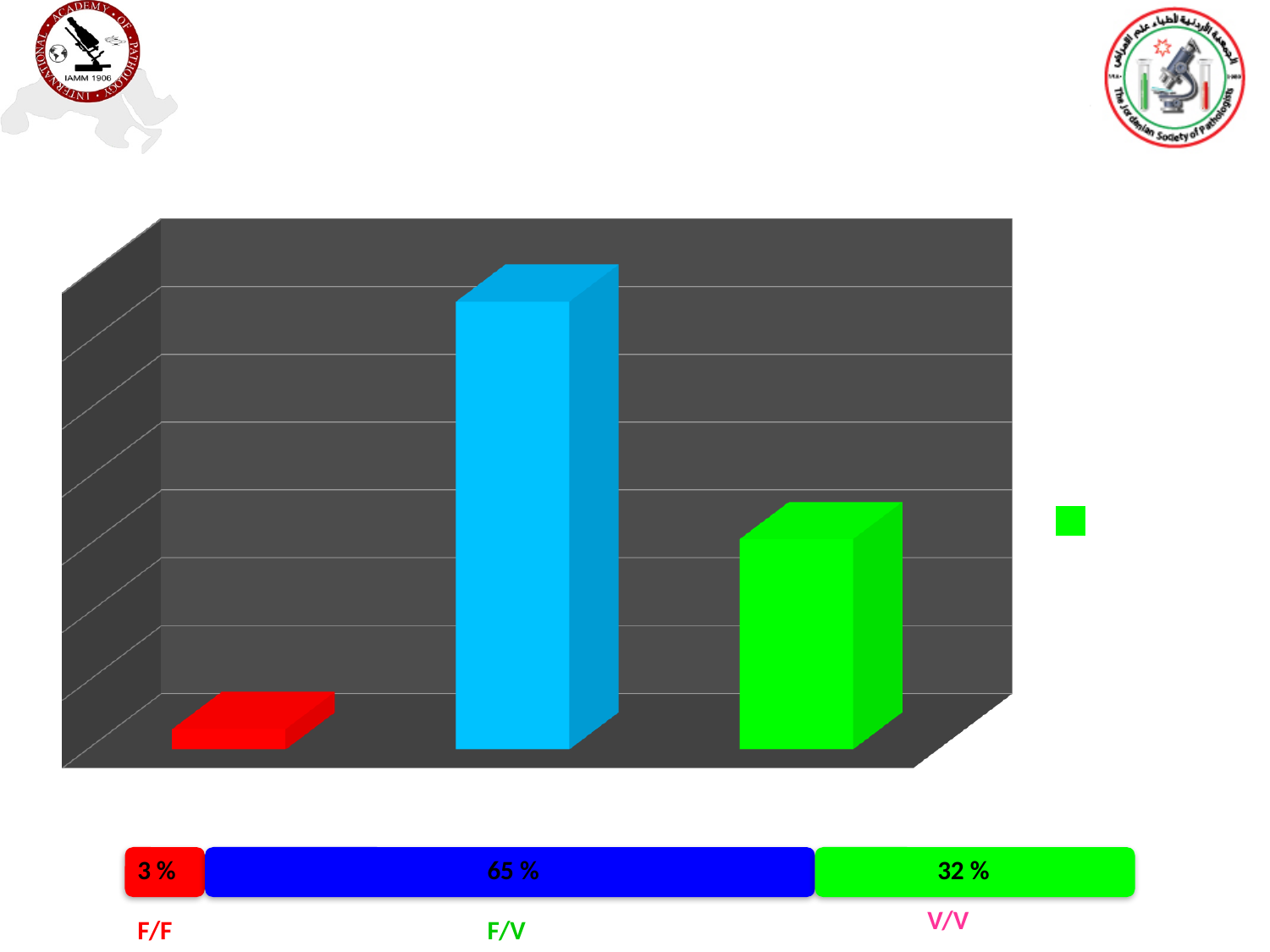
How many bars are plotted in the chart? 3 Which category has the shortest bar in the chart? F/F Which category has the tallest bar in the chart? F/V What is the difference between the percentages for F/V and V/V? 33 % What is the total of the three percentages shown (F/F, F/V and V/V)? 100 % What percentage is shown for F/V? 65 % Which is larger, the value for V/V or the value for F/F? V/V What kind of chart is shown on the slide? bar chart What percentage is shown for V/V? 32 % What colour is the bar for F/F in the chart? red What percentage is shown for F/F? 3 % What colour is the bar for F/V in the chart? blue